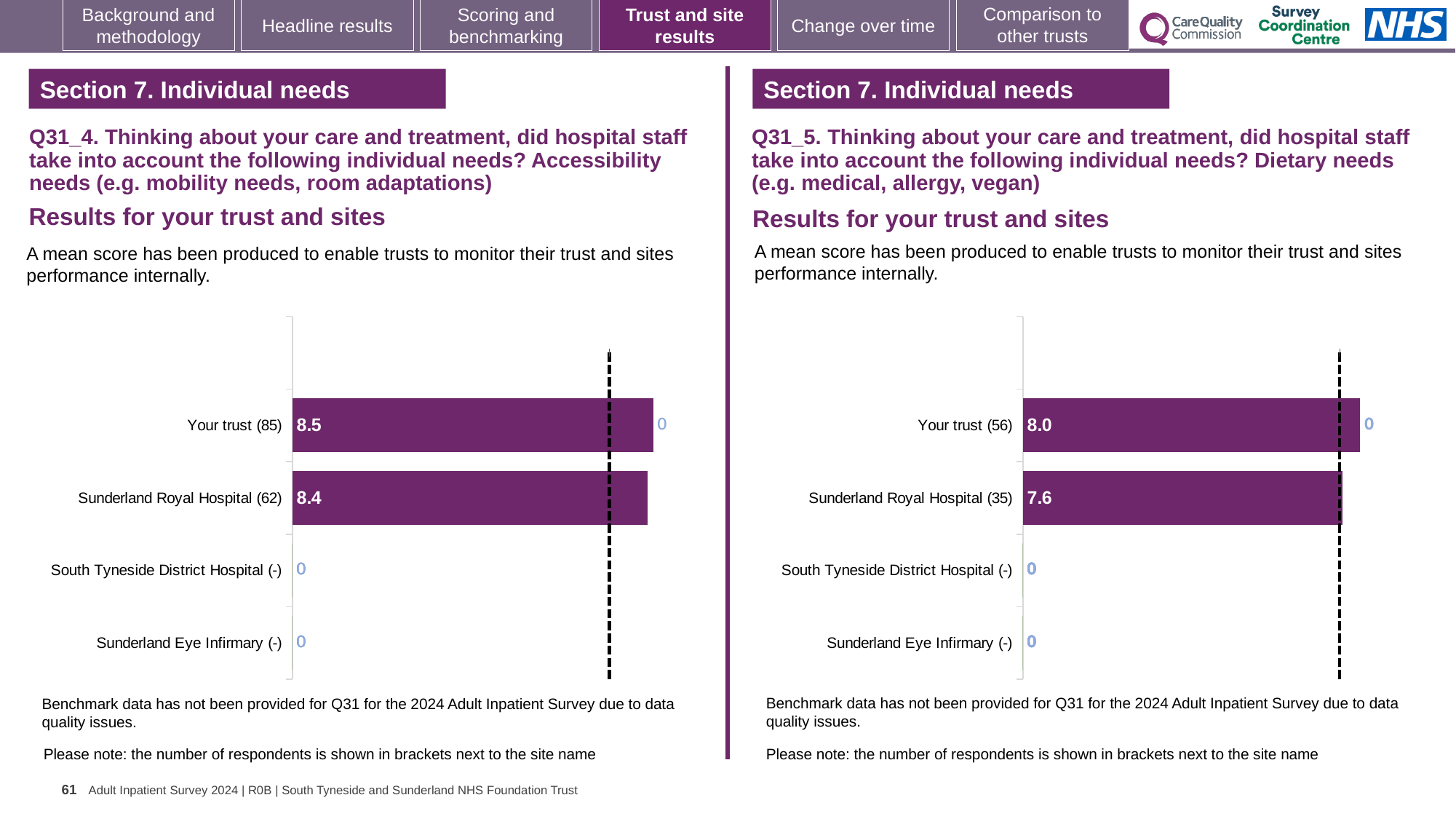
In the Q31_5 Dietary needs chart on the right, what is the mean score for Sunderland Royal Hospital? 7.6 What type of chart is used in the Q31_5 Dietary needs chart on the right? Bar chart In the Q31_4 Accessibility needs chart on the left, what is the mean score for Your trust? 8.5 In the Q31_4 Accessibility needs chart on the left, what is the mean score for Sunderland Royal Hospital? 8.4 In the Q31_5 Dietary needs chart on the right, which has the higher score, Your trust or Sunderland Royal Hospital? Your trust In the Q31_5 Dietary needs chart on the right, what is the difference between the scores for Your trust and Sunderland Royal Hospital? 0.4 In the Q31_4 Accessibility needs chart on the left, what is the difference between the scores for Your trust and Sunderland Royal Hospital? 0.1 In the Q31_4 Accessibility needs chart on the left, which of the plotted bars has the highest score? Your trust In the Q31_4 Accessibility needs chart on the left, how many respondents are shown in brackets for Sunderland Royal Hospital? 62 In the Q31_5 Dietary needs chart on the right, how many respondents are shown in brackets for Your trust? 56 In the Q31_5 Dietary needs chart on the right, what is the mean score for Your trust? 8.0 How many categories are listed on the vertical axis of the Q31_4 Accessibility needs chart on the left? 4